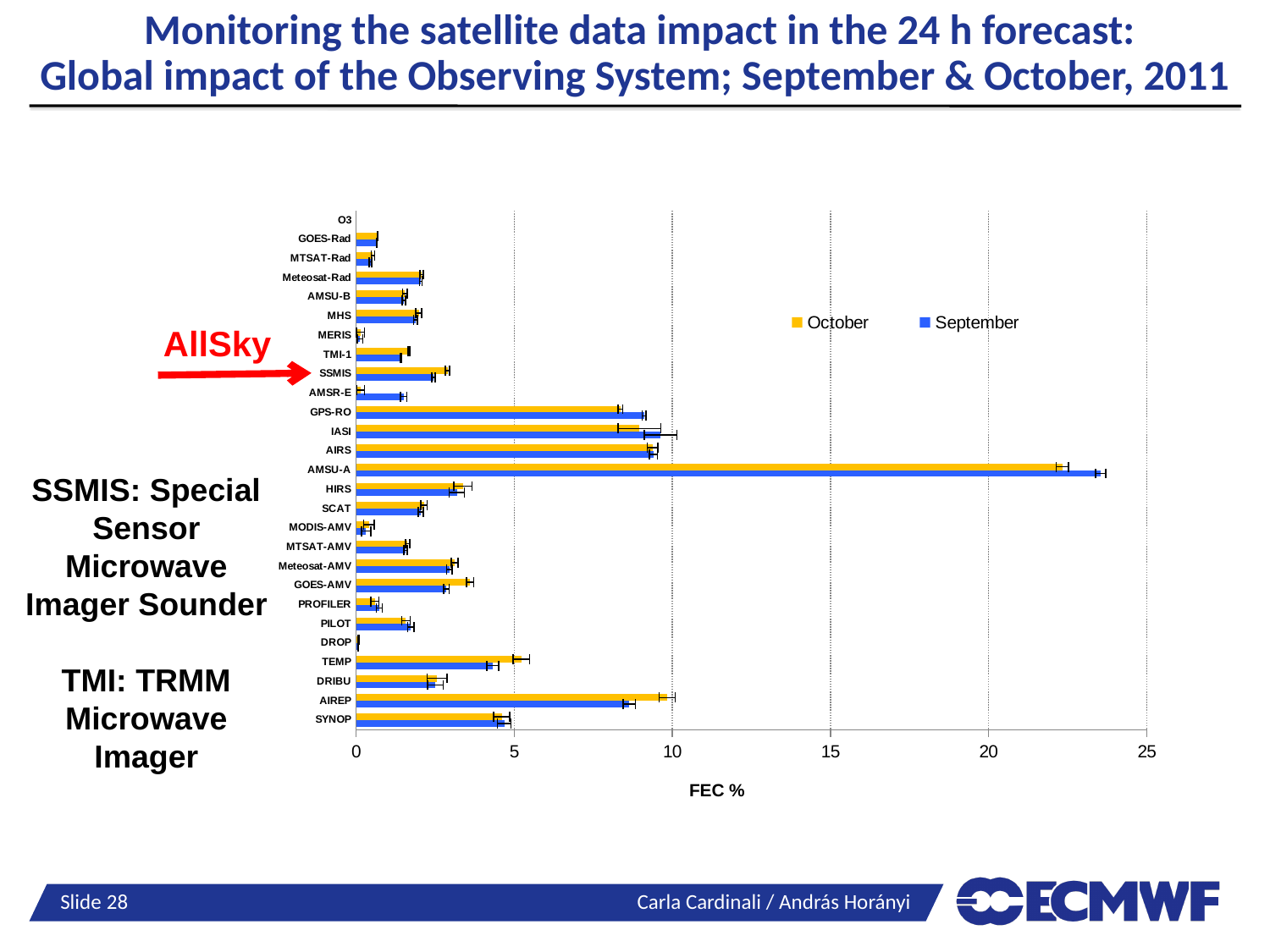
How many observing-system categories are plotted on the chart? 27 How many series does the chart legend list? 2 What kind of chart is shown on the slide? bar chart Which is larger for AMSU-A, the September value or the October value? September Is the September value for GPS-RO greater or less than 10? less Is the October value for SSMIS greater or less than 5? less Which category has the larger October value, AIREP or SYNOP? AIREP Is the September value for AMSU-A greater or less than 20? greater Which category has the highest FEC % value on the chart? AMSU-A Which is larger for AIREP, the October value or the September value? October What is the label on the horizontal axis of the chart? FEC %